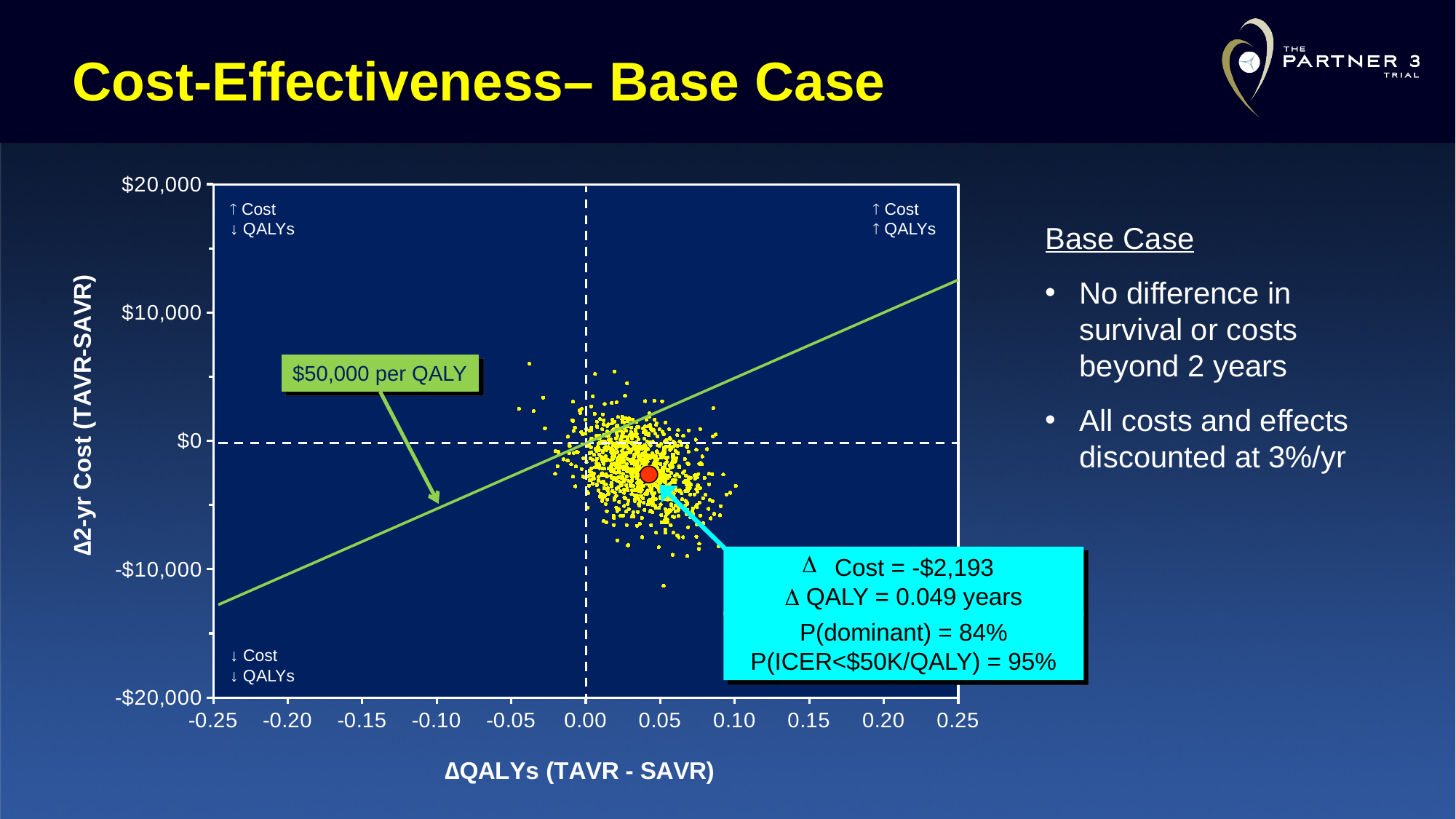
What is the lowest value shown on the x axis? -0.25 What is the title of the x axis? ΔQALYs (TAVR - SAVR) What is the Δ Cost value for the base case point marked in red? -$2,193 Is the ΔQALYs value of the red base case point greater or less than 0.00? greater What is the Δ QALY value for the base case point? 0.049 years What is the highest value shown on the y axis? $20,000 Is the Δ2-yr Cost of the red base case point greater or less than $0? less Is the Δ2-yr Cost of the red base case point greater or less than -$10,000? greater What is P(ICER<$50K/QALY) according to the chart annotation? 95% What kind of chart is shown on the slide? scatter plot What threshold does the green diagonal line represent? $50,000 per QALY What is P(dominant) according to the chart annotation? 84%